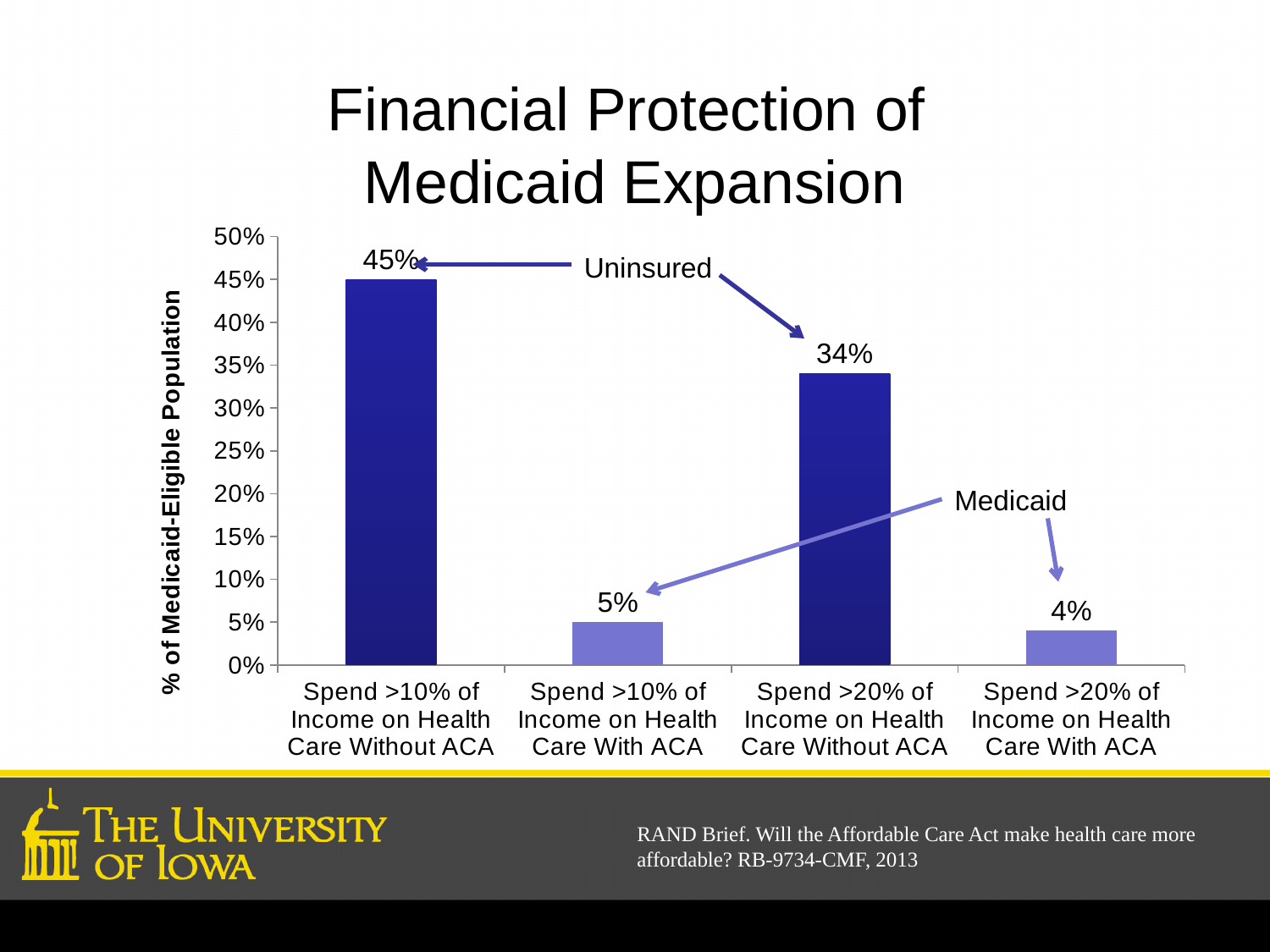
What kind of chart is shown on the slide? Bar chart What is the value for 'Spend >10% of Income on Health Care With ACA'? 5% What is the label of the y axis? % of Medicaid-Eligible Population Which is larger: the value for 'Spend >10% of Income on Health Care Without ACA' or 'Spend >20% of Income on Health Care Without ACA'? Spend >10% of Income on Health Care Without ACA What is the value for 'Spend >10% of Income on Health Care Without ACA'? 45% Which category has the highest value? Spend >10% of Income on Health Care Without ACA Which category has the lowest value? Spend >20% of Income on Health Care With ACA How many categories are shown on the x axis? 4 What is the difference between the values for 'Spend >10% of Income on Health Care Without ACA' and 'Spend >10% of Income on Health Care With ACA'? 40% What is the difference between the values for 'Spend >20% of Income on Health Care Without ACA' and 'Spend >20% of Income on Health Care With ACA'? 30% What is the value for 'Spend >20% of Income on Health Care With ACA'? 4% What is the value for 'Spend >20% of Income on Health Care Without ACA'? 34%